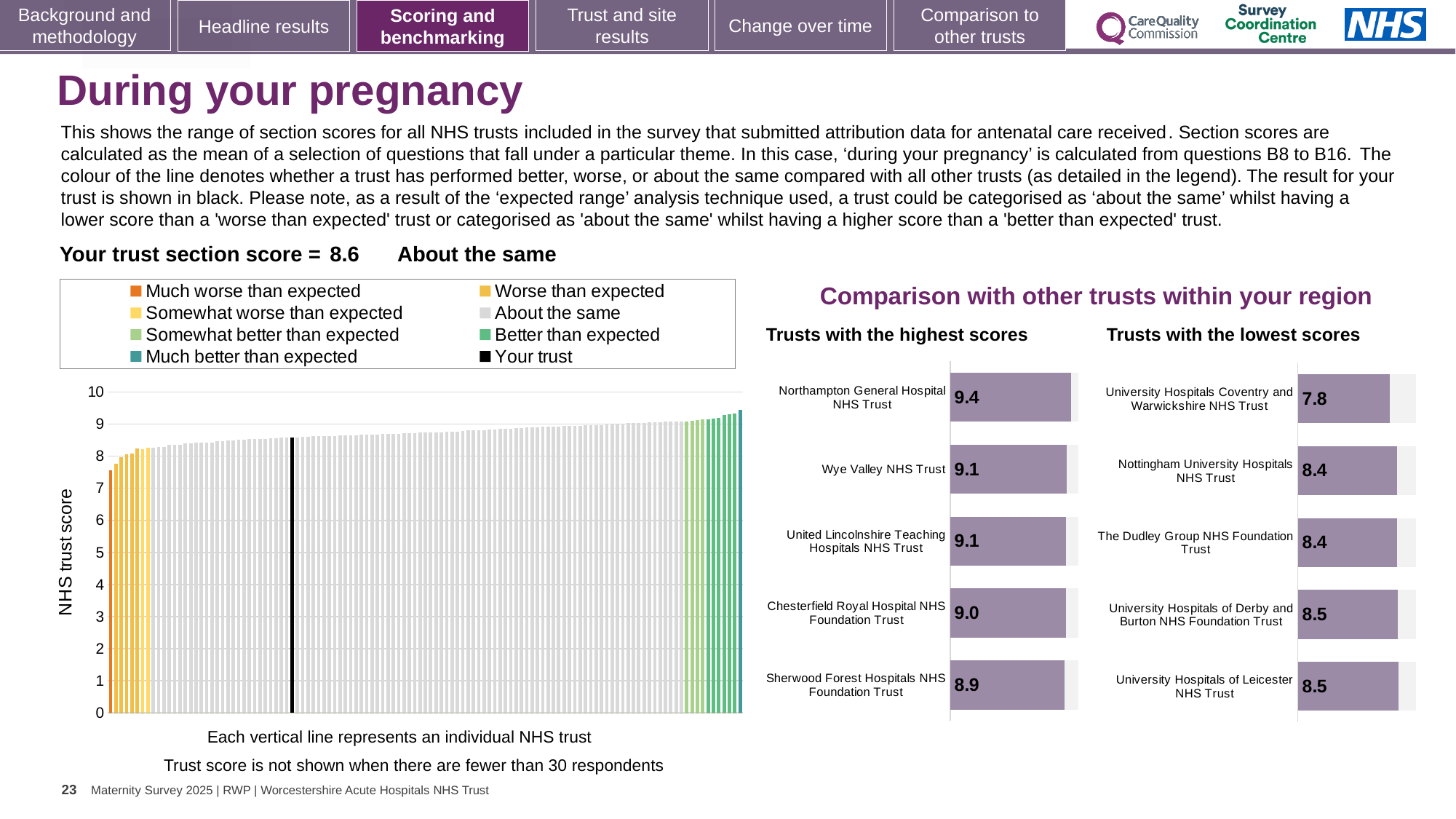
In the 'Trusts with the lowest scores' chart, what is the difference between the scores of University Hospitals of Leicester NHS Trust and University Hospitals Coventry and Warwickshire NHS Trust? 0.7 What is the label on the vertical axis of the left-hand chart? NHS trust score In the 'Trusts with the highest scores' chart, what is the score for Northampton General Hospital NHS Trust? 9.4 In the 'Trusts with the highest scores' chart, which has the higher score: Wye Valley NHS Trust or Chesterfield Royal Hospital NHS Foundation Trust? Wye Valley NHS Trust In the 'Trusts with the lowest scores' chart, what is the score for University Hospitals Coventry and Warwickshire NHS Trust? 7.8 In the 'Trusts with the highest scores' chart, which trust has the highest score? Northampton General Hospital NHS Trust What kind of chart is the large chart on the left showing NHS trust scores? Bar chart How many entries does the legend of the left-hand chart list? 8 In the 'Trusts with the highest scores' chart, what is the difference between the scores of Northampton General Hospital NHS Trust and Sherwood Forest Hospitals NHS Foundation Trust? 0.5 How many trusts are shown in the 'Trusts with the highest scores' chart? 5 In the left-hand chart, what is the section score for your trust (the black bar)? 8.6 In the 'Trusts with the lowest scores' chart, which trust has the lowest score? University Hospitals Coventry and Warwickshire NHS Trust